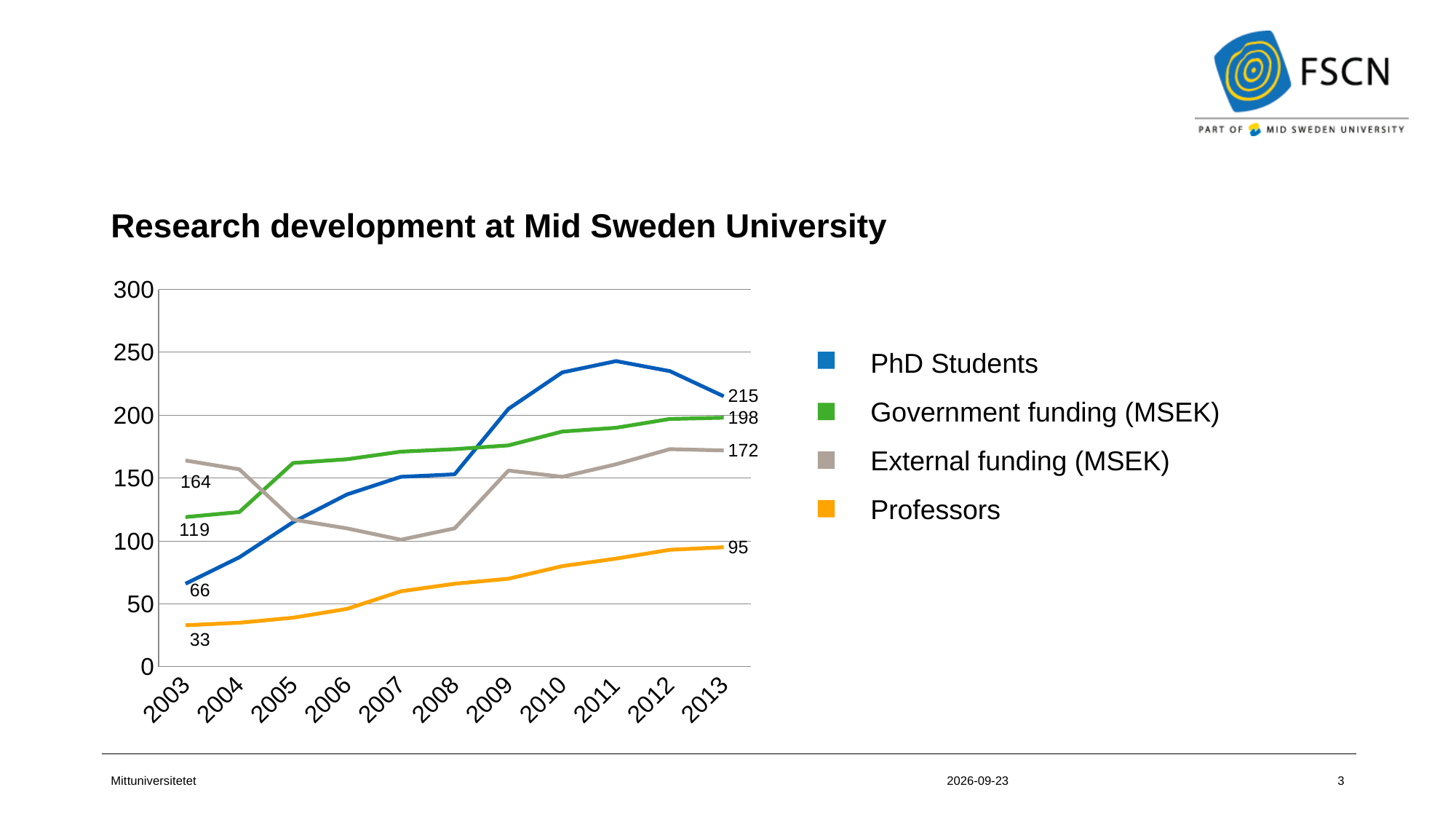
Which series has the lowest value in 2013? Professors How many series does the legend list? 4 What is the value for Government funding (MSEK) in 2003? 119 What is the value for External funding (MSEK) in 2013? 172 What is the value for Professors in 2003? 33 By how much did the number of PhD Students increase from 2003 to 2013? 149 What kind of chart is shown on the slide? line chart How many years are shown on the x axis? 11 Which series has the highest value in 2003? External funding (MSEK) Which is larger in 2013, Government funding (MSEK) or External funding (MSEK)? Government funding (MSEK) What is the value for PhD Students in 2013? 215 Is the value for PhD Students in 2011 greater or less than 200? greater